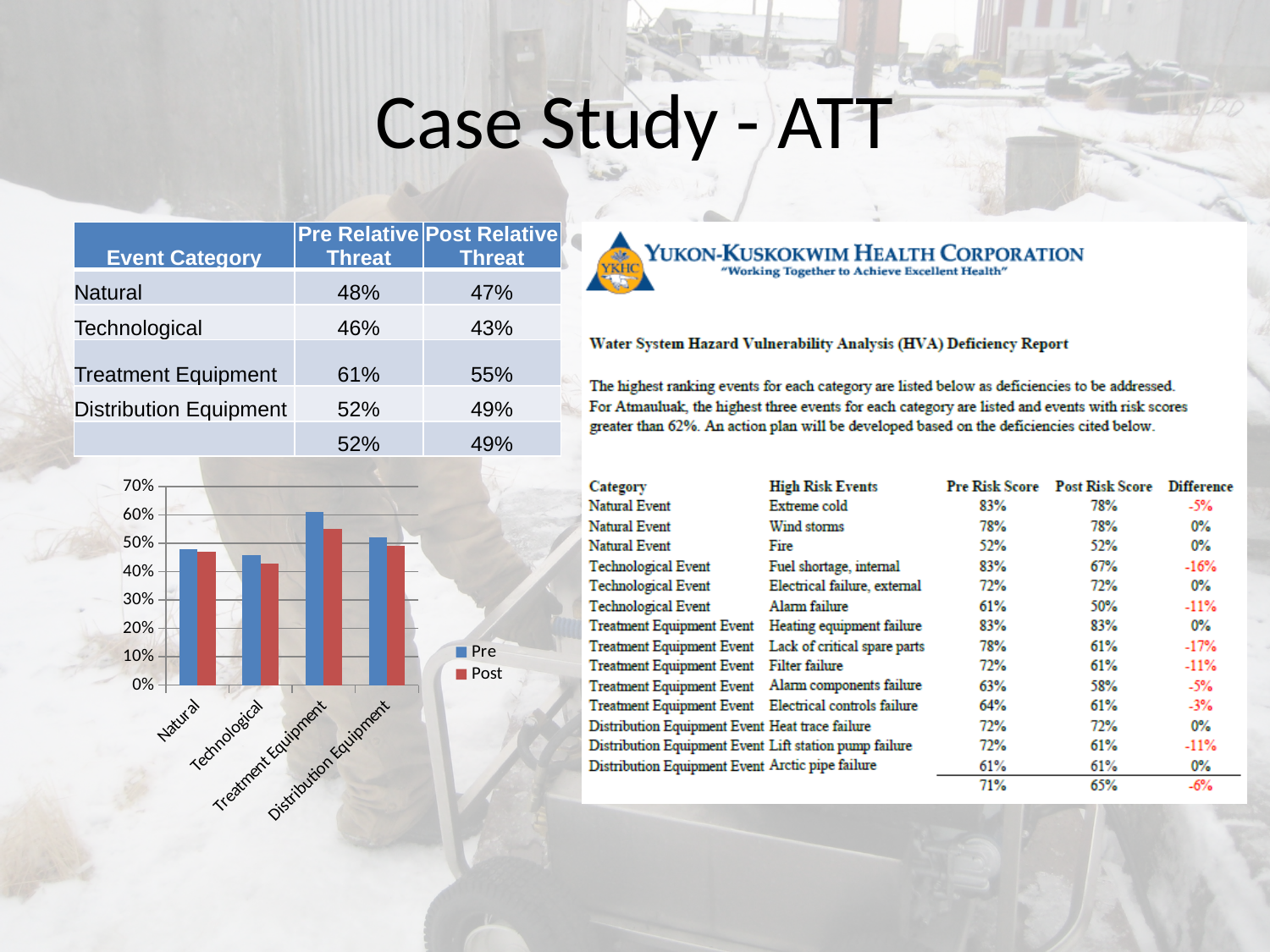
What kind of chart is shown on the slide? bar chart According to the table on the slide, what is the Pre Relative Threat for Natural? 48% Which colour represents the Post series in the chart's legend? red How many series does the chart's legend list? 2 Is the Post value for Technological greater or less than 50%? less How many event categories are plotted on the x axis of the chart? 4 For Treatment Equipment, which bar is taller, Pre or Post? Pre Which event category has the highest Pre bar in the chart? Treatment Equipment Which event category has the lowest Post bar in the chart? Technological Is the Pre value for Treatment Equipment greater or less than 60%? greater According to the table on the slide, what is the difference between the Pre and Post Relative Threat for Treatment Equipment? 6% Is the Pre bar for Distribution Equipment greater or less than 50%? greater